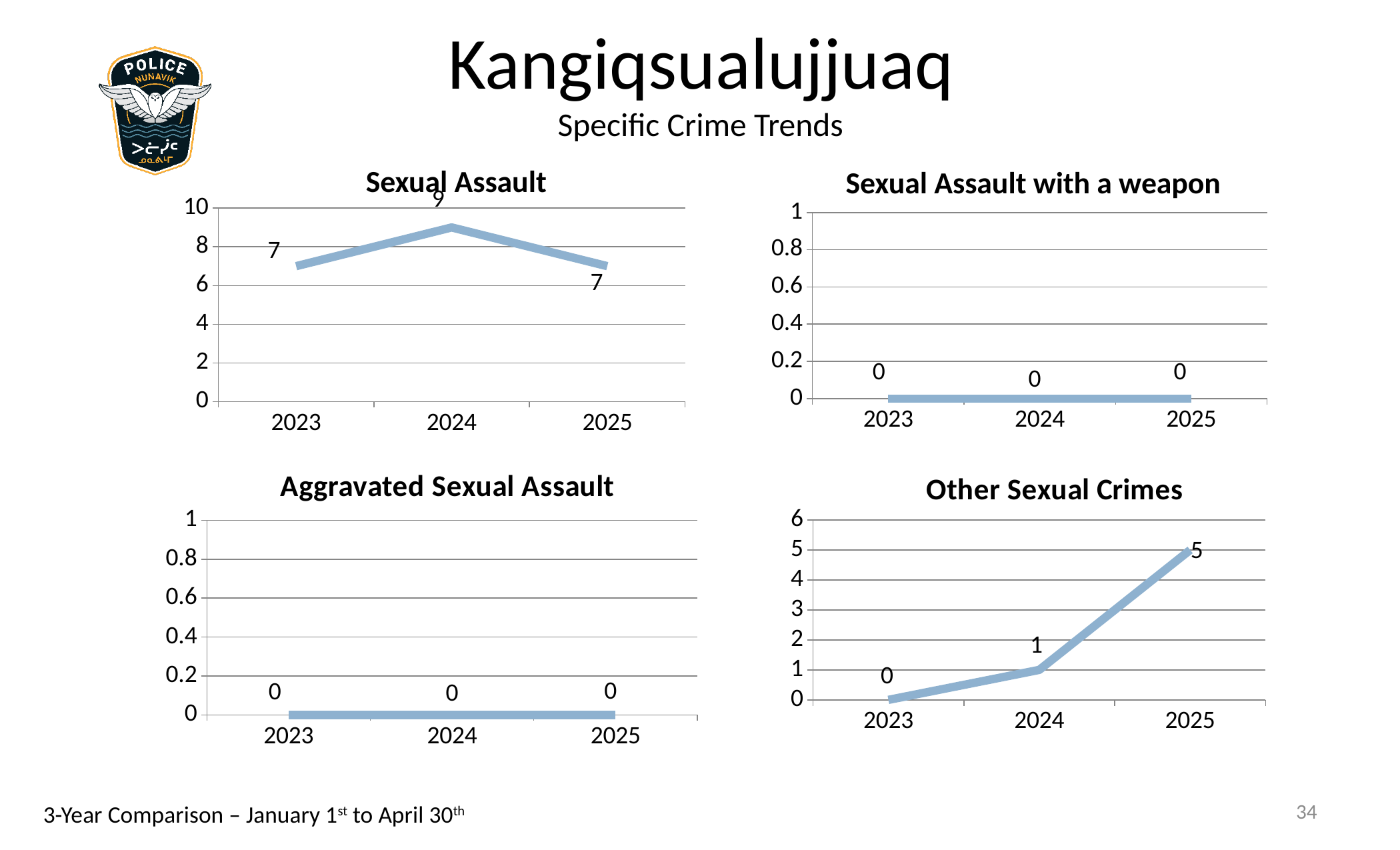
In the Other Sexual Crimes chart, what is the value for 2024? 1 How many years are plotted in the Aggravated Sexual Assault chart? 3 In the Other Sexual Crimes chart, what is the value for 2025? 5 In the Sexual Assault chart, what is the difference between the 2024 and 2025 values? 2 In the Other Sexual Crimes chart, do the values rise or fall from 2023 to 2025? rise In the Sexual Assault chart, what is the value for 2023? 7 In the Sexual Assault chart, which year has the highest value? 2024 In the Sexual Assault with a weapon chart, what is the value for 2024? 0 In the Sexual Assault chart, what is the value for 2024? 9 What kind of chart is the Sexual Assault chart? line chart In the Other Sexual Crimes chart, what is the difference between the 2025 and 2024 values? 4 In the Other Sexual Crimes chart, which year has the lowest value? 2023